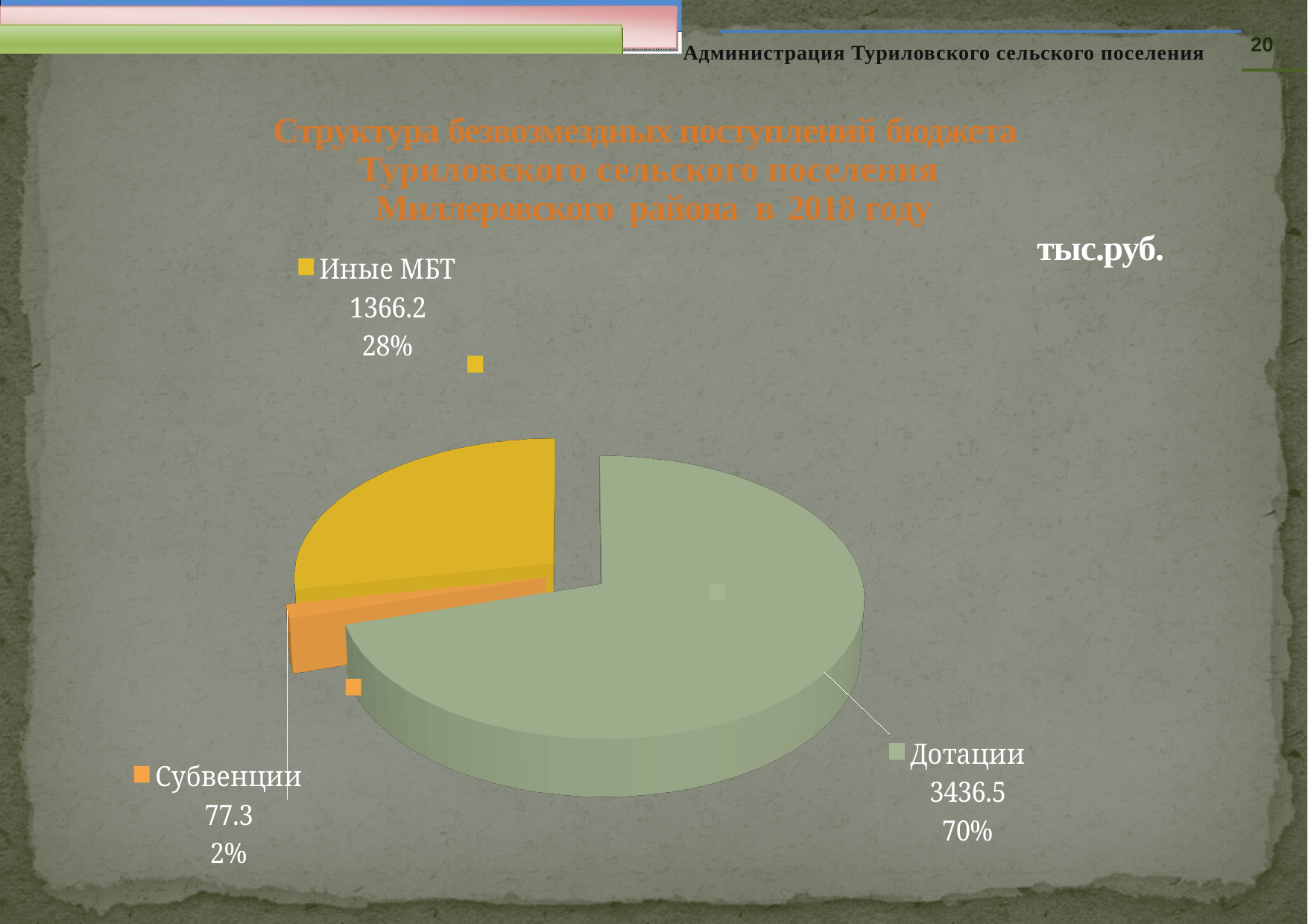
What is the value for Иные МБТ? 1366.2 How many categories are shown in the pie chart? 3 What is the value for Субвенции? 77.3 What share of the pie does Иные МБТ represent? 28% Which category has the largest slice of the pie? Дотации What is the value for Дотации? 3436.5 Which category has the smallest slice of the pie? Субвенции What kind of chart is shown on the slide? Pie chart What share of the pie does Субвенции represent? 2% What is the difference between the values for Дотации and Иные МБТ? 2070.3 What share of the pie does Дотации represent? 70% In what units are the values on the chart given? тыс.руб.